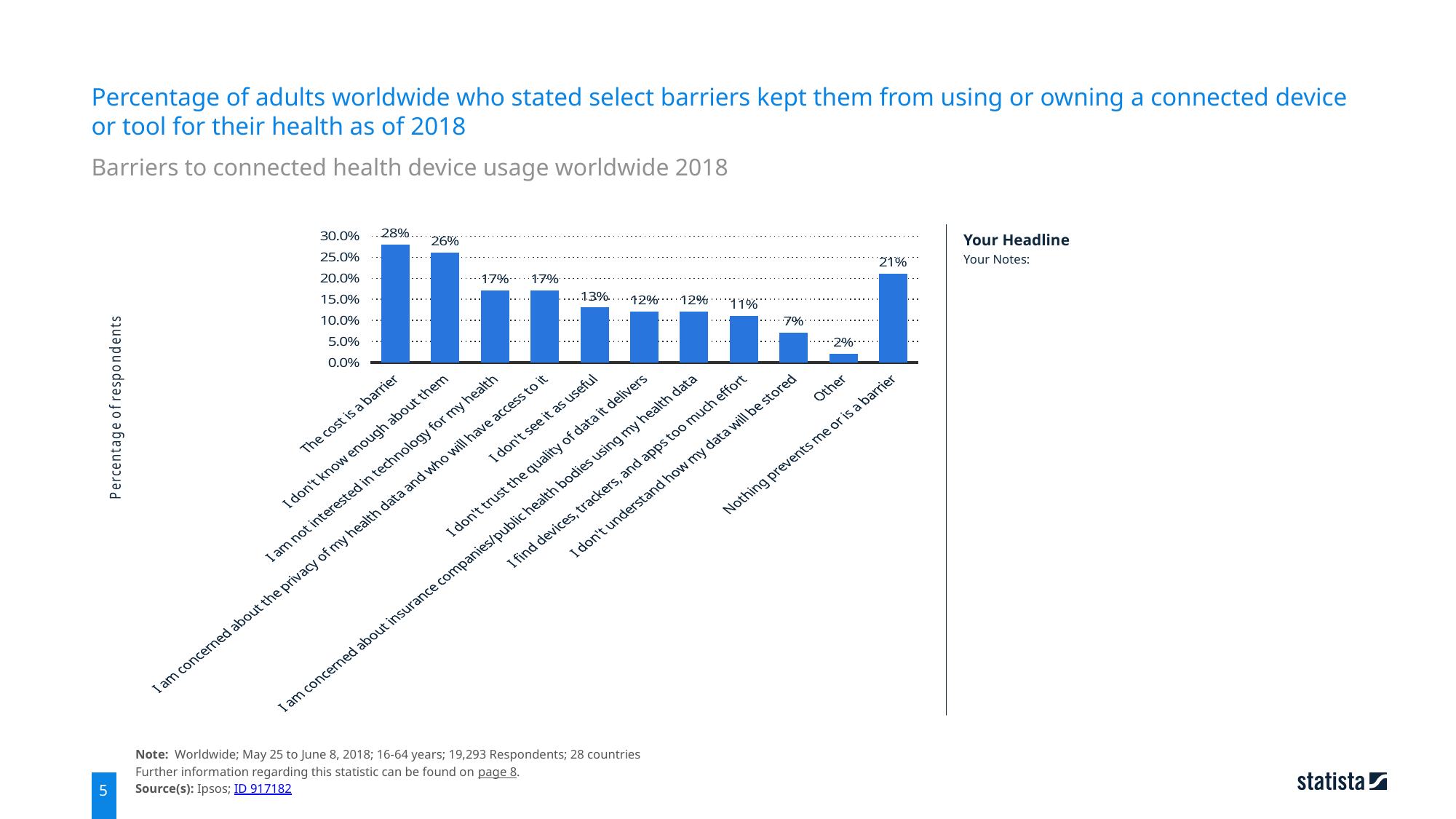
How many barrier categories are shown in the chart? 11 What is the label of the vertical axis? Percentage of respondents Which is larger: the value for 'I find devices, trackers, and apps too much effort' or the value for 'I don't understand how my data will be stored'? I find devices, trackers, and apps too much effort What percentage of respondents said they don't see it as useful? 13% What percentage of respondents stated that the cost is a barrier? 28% Which category has the lowest percentage of respondents? Other Is the value for 'I am not interested in technology for my health' greater or less than 15.0%? greater What is the difference in percentage points between 'The cost is a barrier' and 'I don't know enough about them'? 2 percentage points Which barrier has the highest percentage of respondents? The cost is a barrier What type of chart is shown on the slide? Bar chart What percentage of respondents said nothing prevents them or is a barrier? 21% What percentage of respondents chose 'Other'? 2%